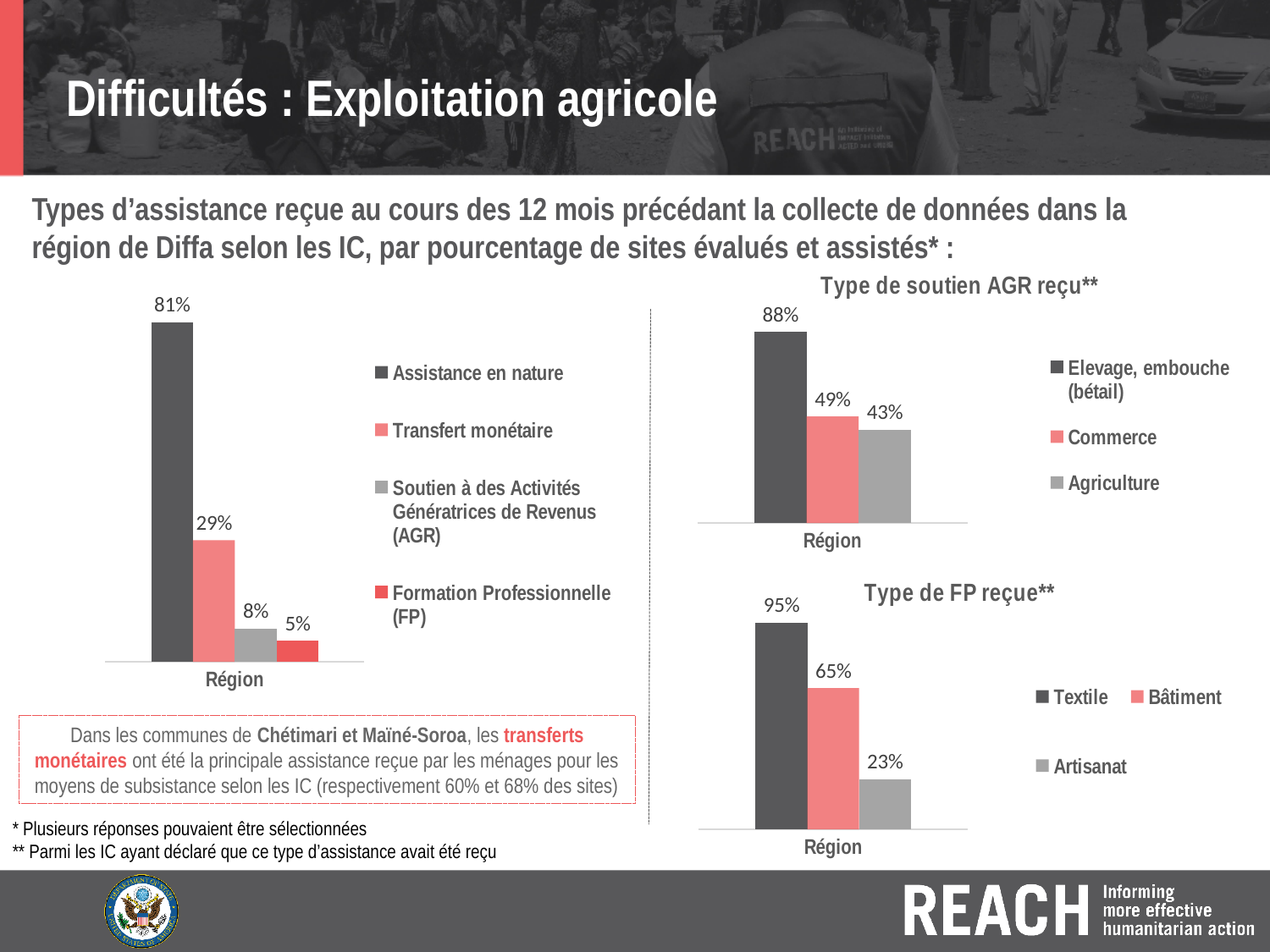
In the left chart, which series has the lowest value? Formation Professionnelle (FP) In the left chart, what is the value for Transfert monétaire? 29% In the chart titled 'Type de soutien AGR reçu', which series has the highest value? Elevage, embouche (bétail) In the chart titled 'Type de soutien AGR reçu', what is the value for Commerce? 49% In the chart titled 'Type de FP reçue', what is the difference between Textile and Bâtiment? 30% In the left chart, what is the value for Assistance en nature? 81% In the left chart, how many series does the legend list? 4 In the chart titled 'Type de FP reçue', which is larger, Textile or Bâtiment? Textile What kind of chart is the chart titled 'Type de FP reçue'? Bar chart In the chart titled 'Type de FP reçue', what is the value for Artisanat? 23% In the left chart, what is the difference between Assistance en nature and Transfert monétaire? 52% In the chart titled 'Type de soutien AGR reçu', what is the difference between Elevage, embouche (bétail) and Agriculture? 45%